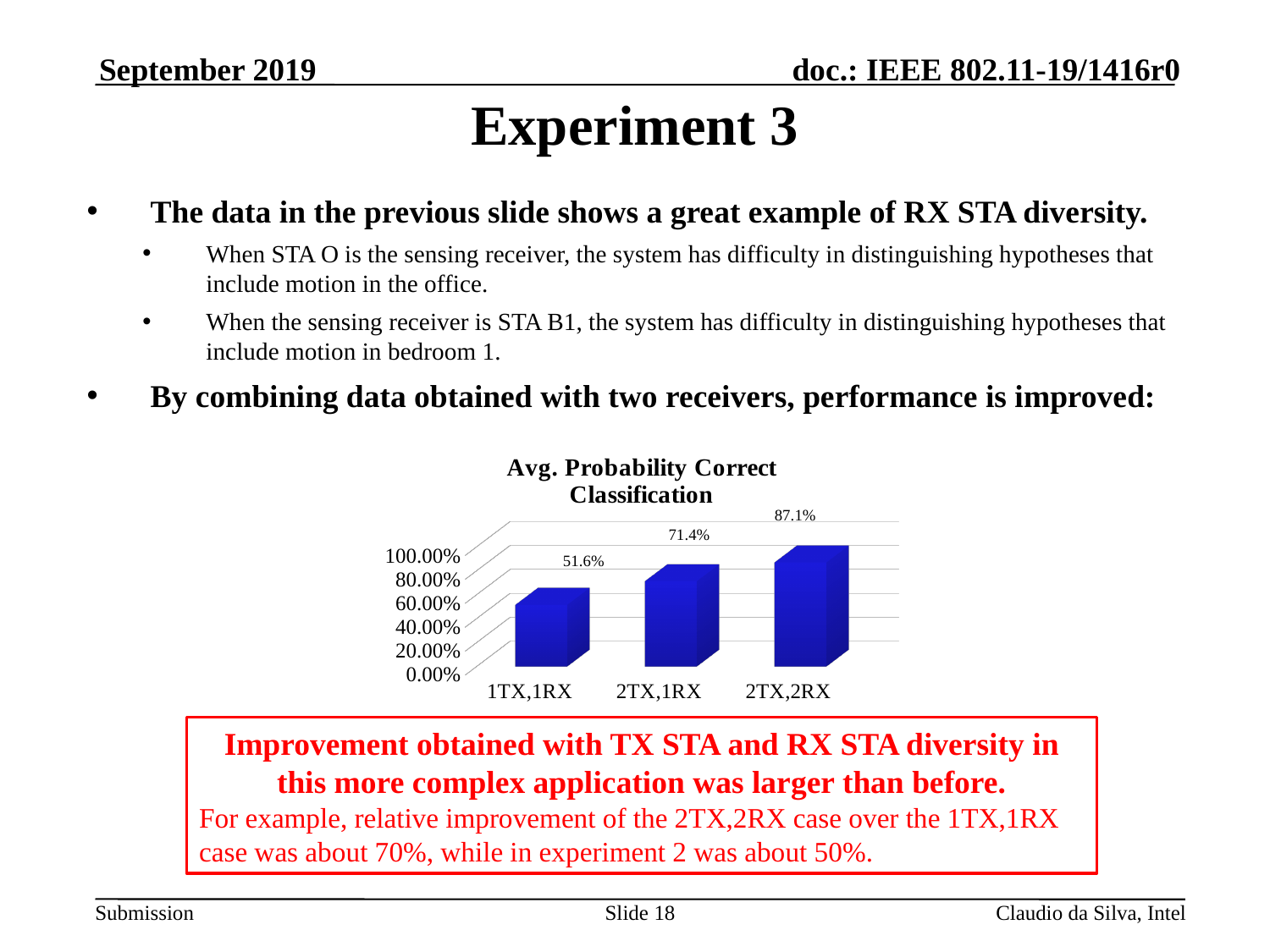
What is the average probability of correct classification for the 2TX,2RX case? 87.1% What is the average probability of correct classification for the 1TX,1RX case? 51.6% Which configuration has the lowest average probability of correct classification? 1TX,1RX How many configurations are shown in the chart? 3 Which has a higher average probability of correct classification, 2TX,1RX or 2TX,2RX? 2TX,2RX What is the average probability of correct classification for the 2TX,1RX case? 71.4% Do the values rise or fall from 1TX,1RX to 2TX,2RX? rise What is the difference in average probability of correct classification between the 2TX,1RX and 1TX,1RX cases? 19.8% What is the difference in average probability of correct classification between the 2TX,2RX and 1TX,1RX cases? 35.5% What kind of chart is used to show the average probability of correct classification? bar chart Which configuration has the highest average probability of correct classification? 2TX,2RX Is the value for 1TX,1RX greater or less than 60.00%? less